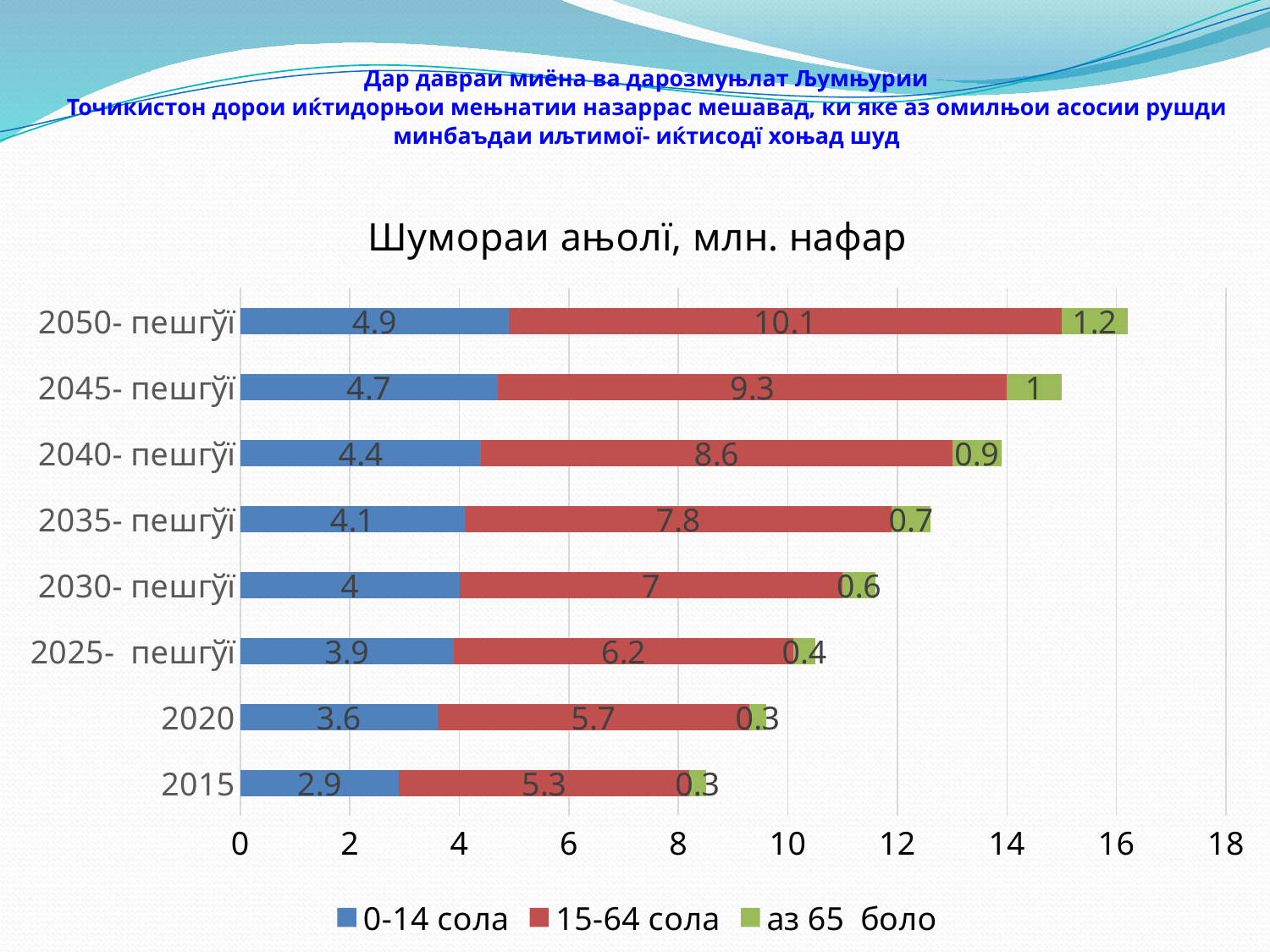
Which category has the lowest value for the 0-14 сола series? 2015 What is the value of the 0-14 сола series for 2015? 2.9 How many categories are shown on the chart? 8 What is the value of the 15-64 сола series for 2050- пешгӯӣ? 10.1 How many series does the legend list? 3 Which category has the highest value for the 15-64 сола series? 2050- пешгӯӣ What is the total of the stacked bar for 2030- пешгӯӣ? 11.6 What is the value of the аз 65 боло series for 2040- пешгӯӣ? 0.9 What type of chart is shown on the slide? Stacked bar chart What is the difference between the 15-64 сола values for 2050- пешгӯӣ and 2015? 4.8 What is the title of the chart? Шумораи ањолї, млн. нафар Which is larger: the 0-14 сола value for 2045- пешгӯӣ or for 2030- пешгӯӣ? 2045- пешгӯӣ